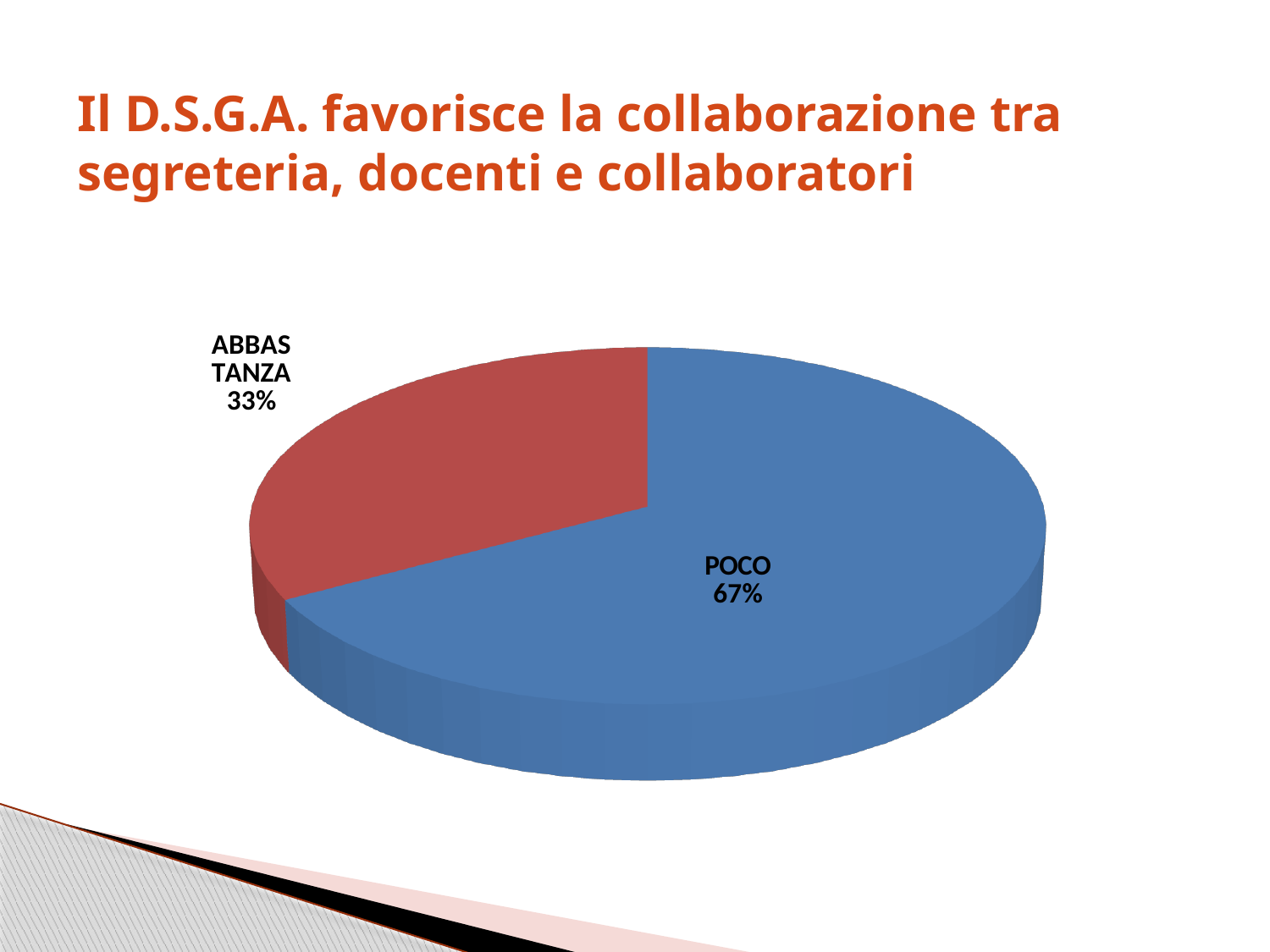
What is the total of the two slice percentages shown? 100% How many slices does the pie chart have? 2 What is the difference in percentage points between the POCO and ABBASTANZA slices? 34 What share of the pie does the POCO slice represent? 67% What colour is the ABBASTANZA slice? Red Which slice is the smallest in the pie chart? ABBASTANZA Which slice is the largest in the pie chart? POCO Which slice is larger, POCO or ABBASTANZA? POCO What share of the pie does the ABBASTANZA slice represent? 33% What kind of chart is shown on the slide? Pie chart What colour is the POCO slice? Blue